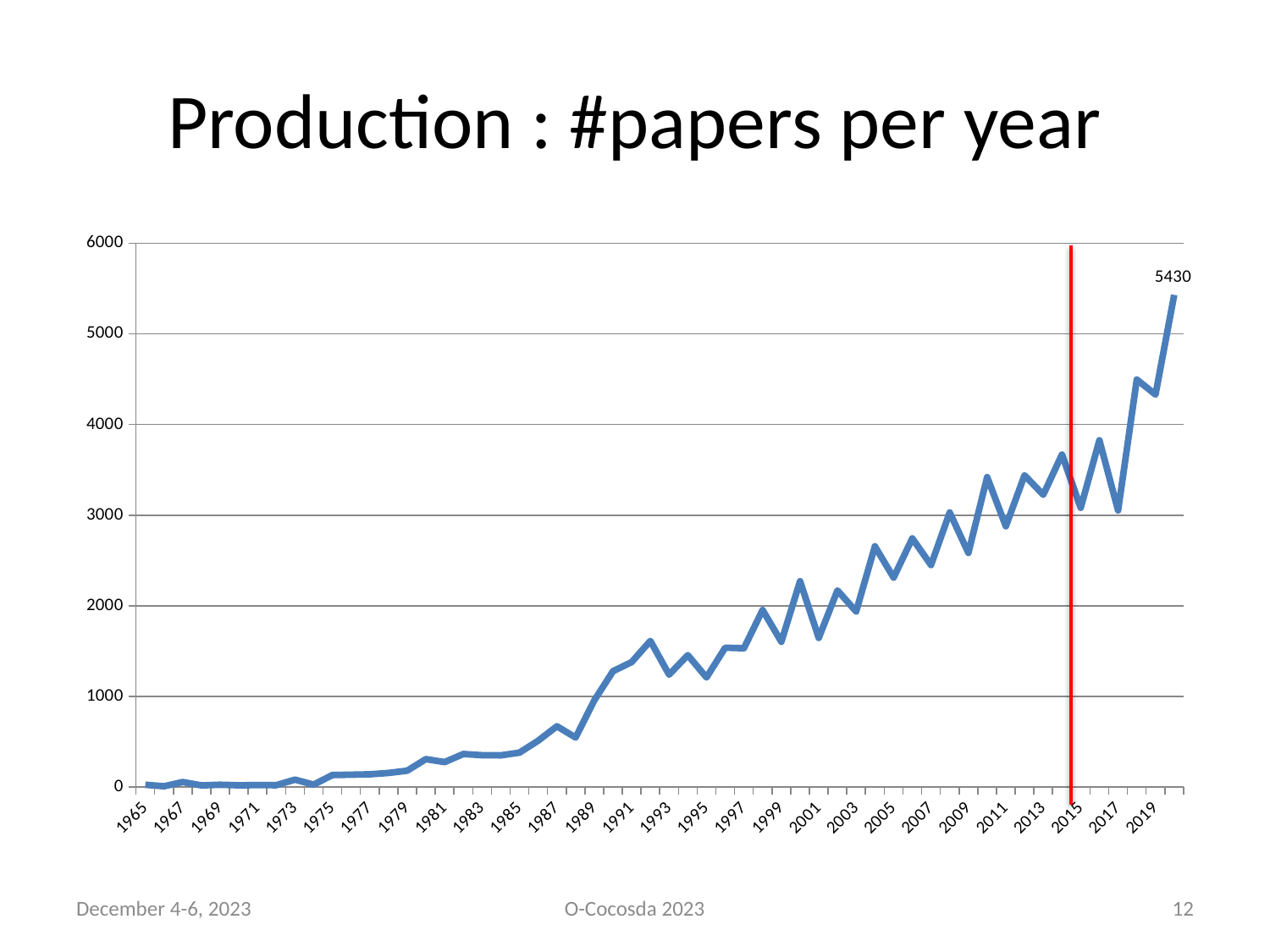
What kind of chart is shown on the slide? line chart What is the highest value shown on the chart? 5430 What is the title of the chart? Production : #papers per year Which year has the larger value, 1991 or 2001? 2001 Is the value for 2019 greater or less than 4000? greater Is the value for 1985 greater or less than 1000? less Is the value for 2009 greater or less than 2000? greater What is the maximum value shown on the y axis? 6000 At which year is the red vertical line drawn? 2015 What is the value of the data label printed at the end of the line? 5430 Do the values generally rise or fall from 1965 to the end of the chart? rise